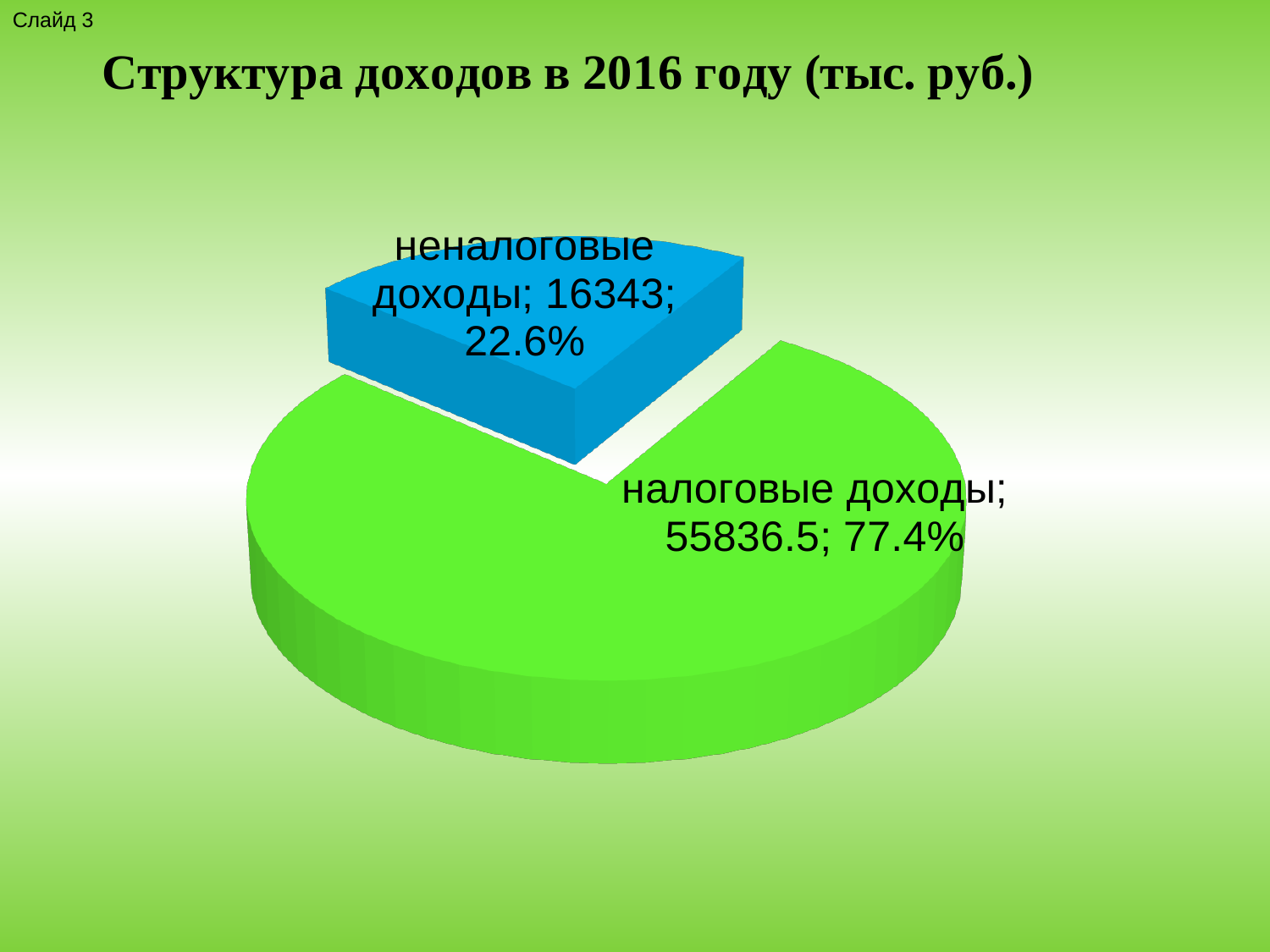
What is the title of the chart? Структура доходов в 2016 году (тыс. руб.) What colour is the slice for неналоговые доходы? blue What share of the pie does налоговые доходы represent? 77.4% What is the value for неналоговые доходы? 16343 What is the value for налоговые доходы? 55836.5 Which category has the smallest slice? неналоговые доходы Which category has the largest slice? налоговые доходы What kind of chart is shown on the slide? pie chart How many slices does the pie chart have? 2 What is the difference between the values for налоговые доходы and неналоговые доходы? 39493.5 What share of the pie does неналоговые доходы represent? 22.6% Which is larger, налоговые доходы or неналоговые доходы? налоговые доходы